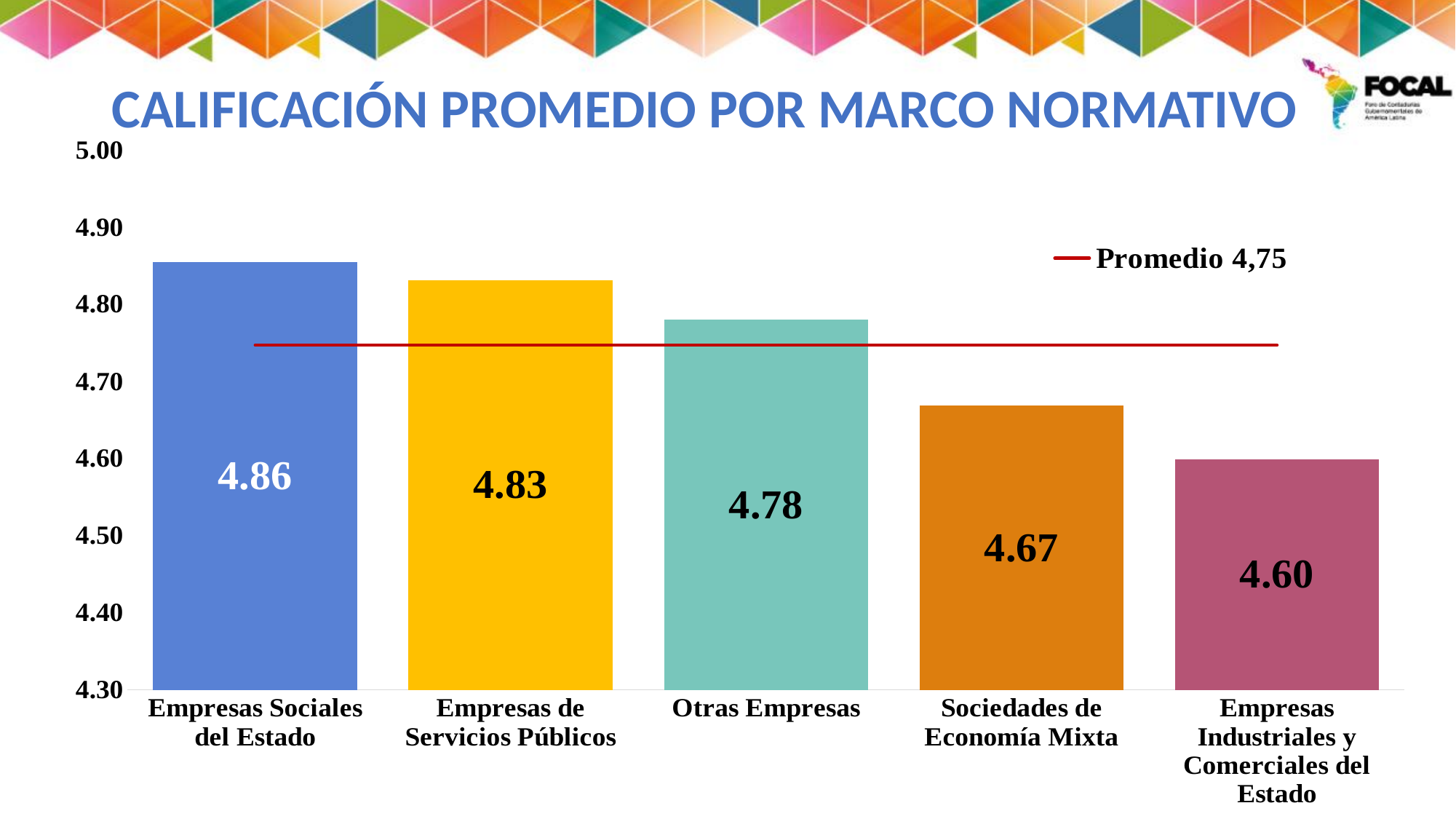
What is the value for Sociedades de Economía Mixta? 4.67 Which category has the lowest value? Empresas Industriales y Comerciales del Estado What value does the red horizontal line labelled in the legend represent? Promedio 4,75 What is the value for Empresas Sociales del Estado? 4.86 Which is larger, the value for Otras Empresas or the value for Sociedades de Economía Mixta? Otras Empresas Which category has the highest value? Empresas Sociales del Estado What is the difference between the values for Empresas de Servicios Públicos and Empresas Industriales y Comerciales del Estado? 0.23 What kind of chart is shown on the slide? bar chart How many categories are shown on the x axis? 5 What is the value for Otras Empresas? 4.78 Do the values rise or fall from left to right along the x axis? fall Is the value for Empresas Industriales y Comerciales del Estado greater or less than 4.70? less